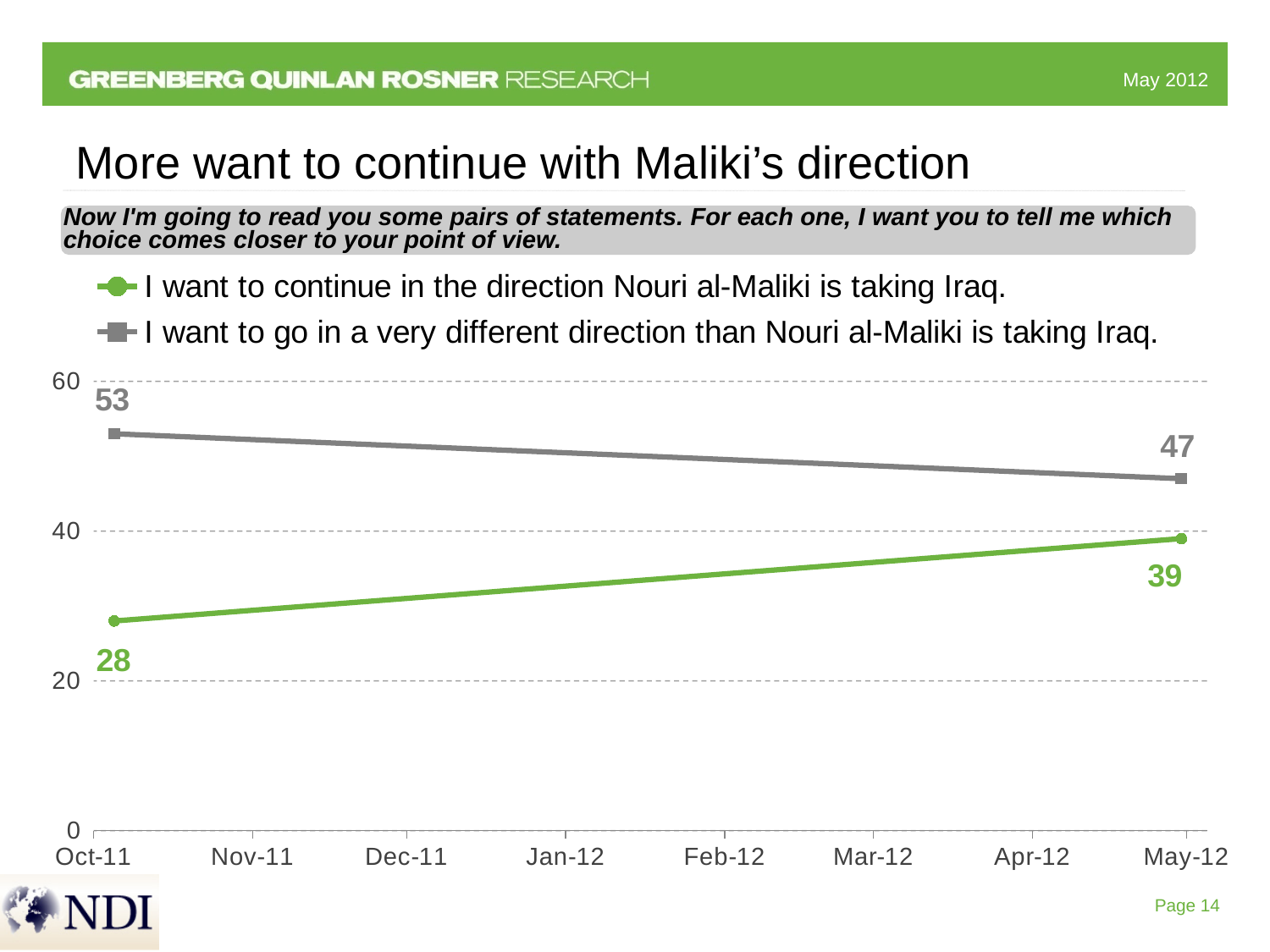
What is the value for 'I want to go in a very different direction than Nouri al-Maliki is taking Iraq' in May-12? 47 By how much did the 'continue in the direction' series change from Oct-11 to May-12? 11 What is the difference between the two series in May-12? 8 What is the value for 'I want to continue in the direction Nouri al-Maliki is taking Iraq' in May-12? 39 What is the value for 'I want to continue in the direction Nouri al-Maliki is taking Iraq' in Oct-11? 28 What kind of chart is shown on the slide? line chart Does the 'I want to continue in the direction' series rise or fall from Oct-11 to May-12? rise What colour is the line for 'I want to continue in the direction Nouri al-Maliki is taking Iraq'? green Which series has the higher value in May-12? I want to go in a very different direction than Nouri al-Maliki is taking Iraq. How many series does the legend list? 2 Does the 'I want to go in a very different direction' series rise or fall from Oct-11 to May-12? fall What is the value for 'I want to go in a very different direction than Nouri al-Maliki is taking Iraq' in Oct-11? 53